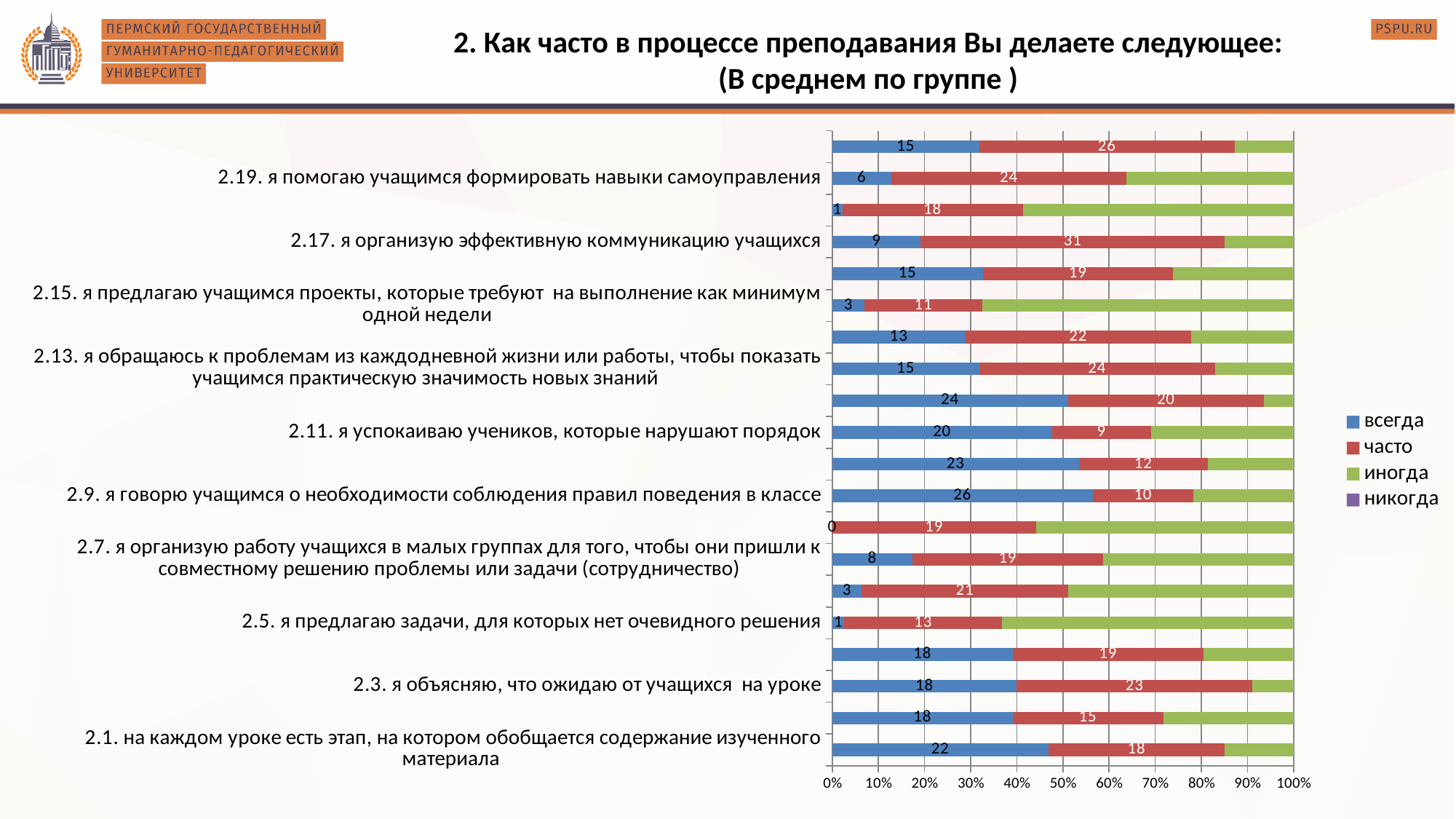
What is the value of the 'часто' series for category 2.17 (я организую эффективную коммуникацию учащихся)? 31 Is the 'всегда' share of the bar for category 2.7 greater or less than 20%? less Which category has the highest value in the 'часто' series? 2.17. я организую эффективную коммуникацию учащихся Which legend entry is shown in red? часто How many series does the legend list? 4 What kind of chart is shown on the slide? bar chart What is the value of the 'всегда' series for category 2.9 (я говорю учащимся о необходимости соблюдения правил поведения в классе)? 26 What is the value of the 'часто' series for category 2.5 (я предлагаю задачи, для которых нет очевидного решения)? 13 Which category has the lowest value in the 'часто' series? 2.11. я успокаиваю учеников, которые нарушают порядок Which has the larger 'всегда' value: category 2.9 or category 2.11? 2.9 For category 2.17, what is the difference between the 'часто' value and the 'всегда' value? 22 What is the value of the 'всегда' series for category 2.1 (на каждом уроке есть этап, на котором обобщается содержание изученного материала)? 22